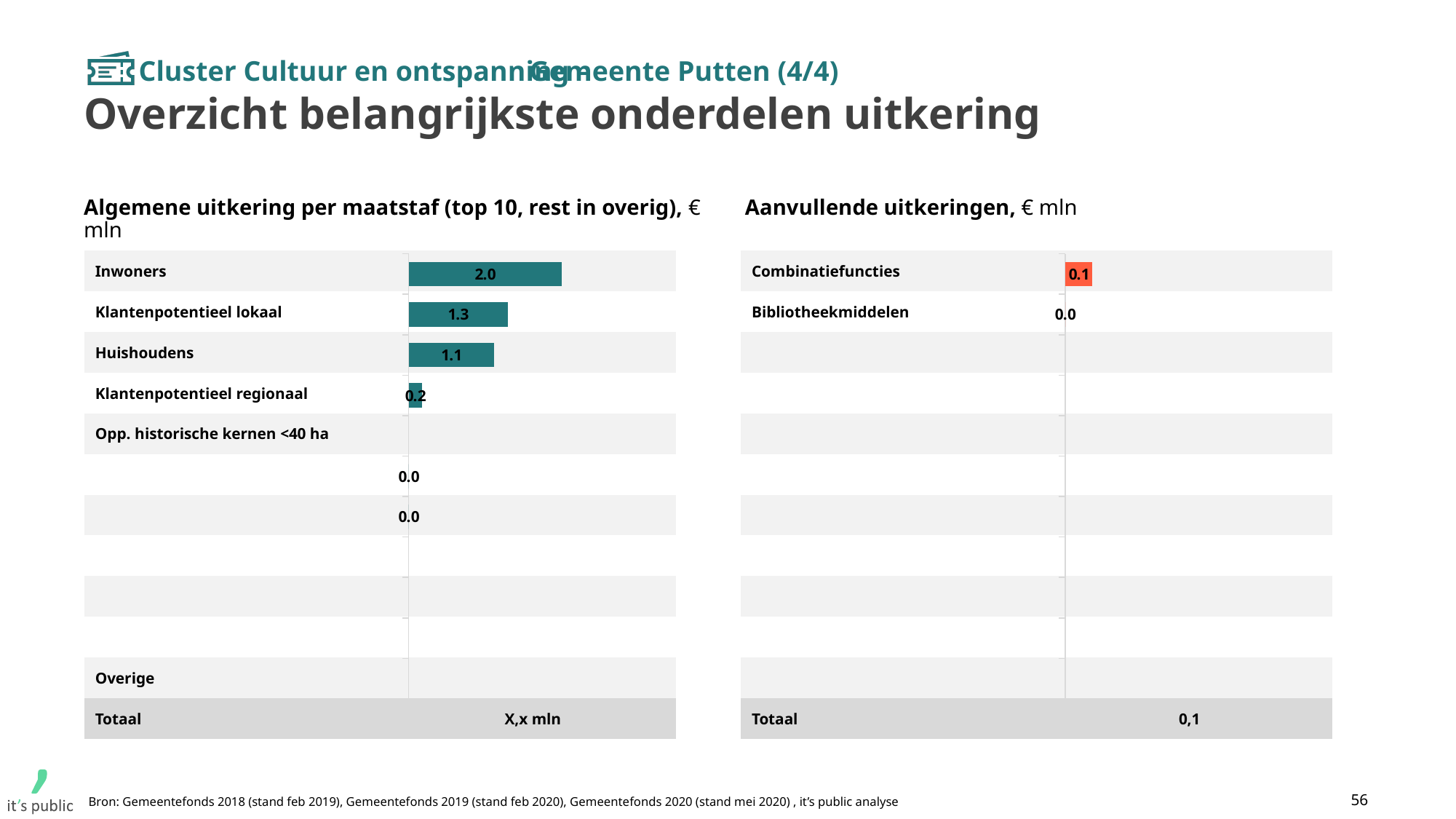
In the 'Aanvullende uitkeringen' chart, what is the value for Combinatiefuncties? 0.1 In the 'Algemene uitkering per maatstaf' chart, what is the difference between Inwoners and Huishoudens? 0.9 In the 'Algemene uitkering per maatstaf' chart, what is the value for Klantenpotentieel lokaal? 1.3 In the 'Algemene uitkering per maatstaf' chart, what is the value for Klantenpotentieel regionaal? 0.2 In the 'Algemene uitkering per maatstaf' chart, what is the value for Inwoners? 2.0 In the 'Algemene uitkering per maatstaf' chart, which category has the highest value? Inwoners In the 'Algemene uitkering per maatstaf' chart, which is larger: Klantenpotentieel lokaal or Huishoudens? Klantenpotentieel lokaal What kind of chart is the 'Algemene uitkering per maatstaf' chart? bar chart In the 'Aanvullende uitkeringen' chart, what is the value for Bibliotheekmiddelen? 0.0 In the 'Algemene uitkering per maatstaf' chart, what is the value for Huishoudens? 1.1 What unit is stated in the title of the 'Aanvullende uitkeringen' chart? € mln In the 'Aanvullende uitkeringen' chart, what is the total shown in the Totaal row? 0,1